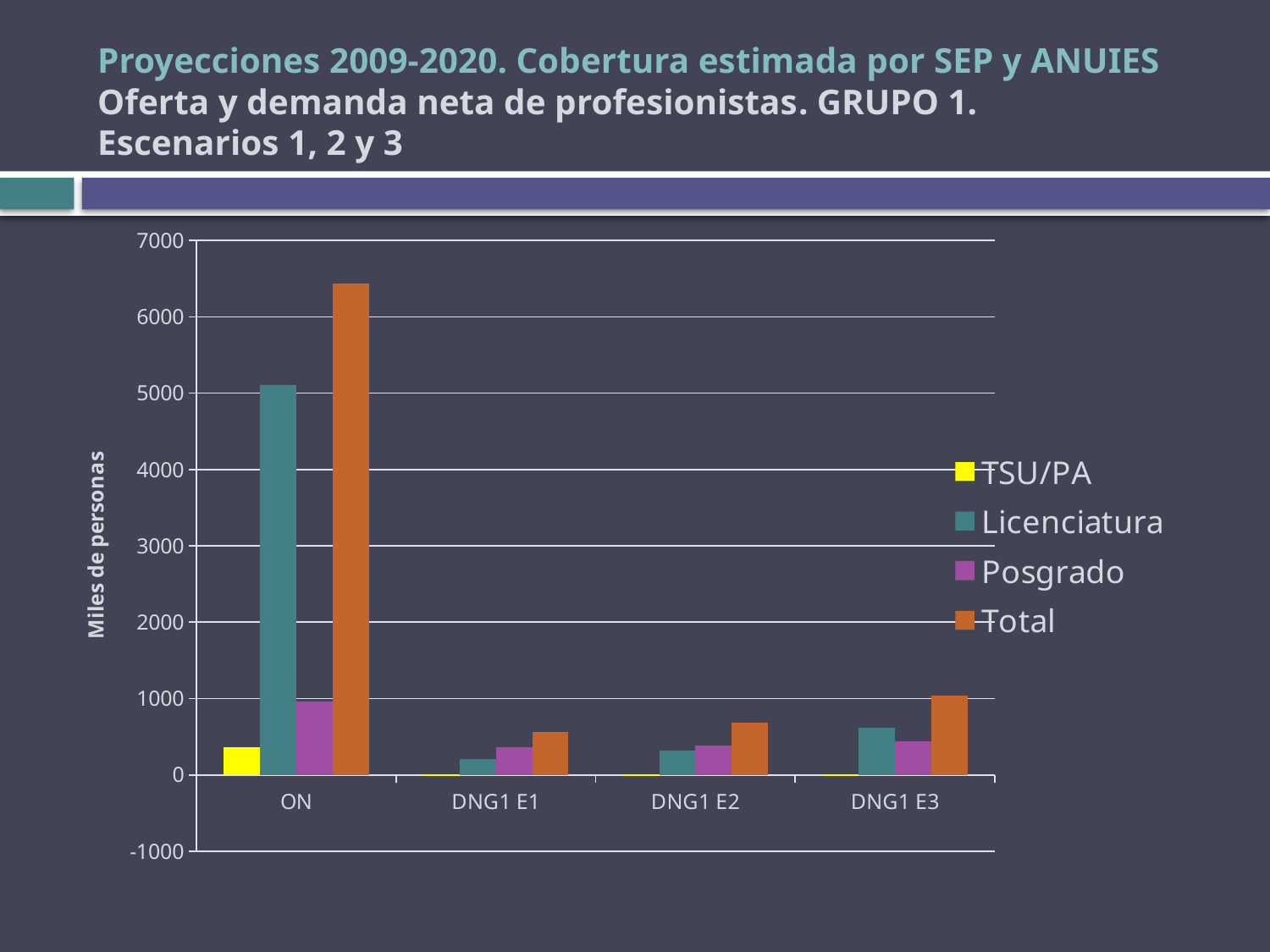
Which category has the highest Total value? ON Do the Total values rise or fall from DNG1 E1 to DNG1 E3? rise How many categories are shown on the x axis? 4 Is the Licenciatura value for ON greater or less than 4000? greater What kind of chart is shown on the slide? bar chart For ON, which is larger: Licenciatura or Posgrado? Licenciatura What is the label on the vertical axis? Miles de personas How many series does the legend list? 4 Is the Total value for DNG1 E1 greater or less than 1000? less Is the Total value for ON greater or less than 6000? greater Which has the larger Total value: DNG1 E1 or DNG1 E3? DNG1 E3 Which category has the lowest Total value? DNG1 E1